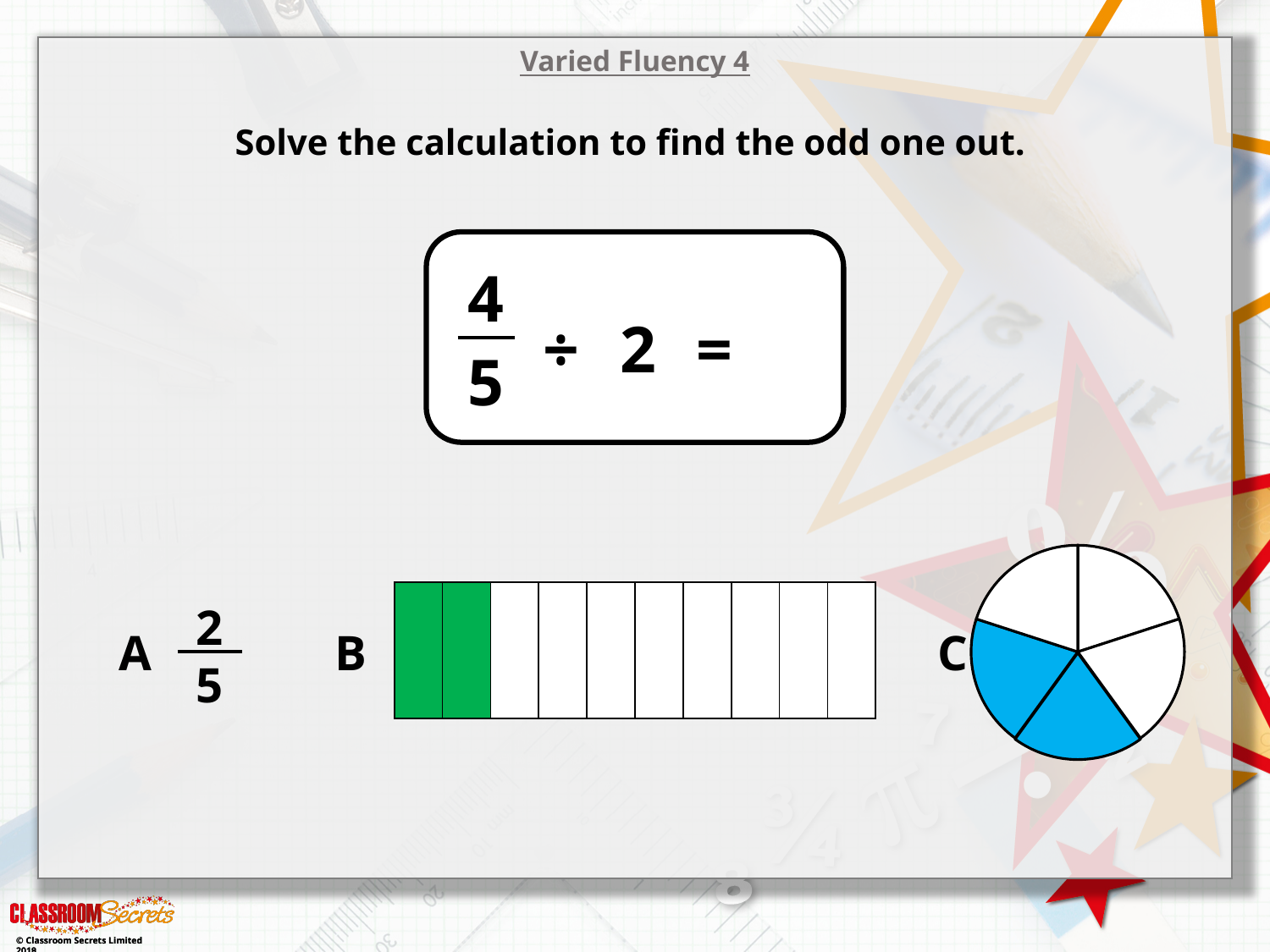
How many sections of the bar in diagram B are shaded green? 2 What colour are the shaded sections of the bar in diagram B? green How many slices is the pie in diagram C divided into? 5 How many slices of the pie in diagram C are shaded blue? 2 What fraction of the pie in diagram C is shaded blue? 2/5 In diagram C, are more slices shaded blue or left white? white What fraction of the bar in diagram B is shaded green? 2/10 What kind of chart is diagram C on the slide? pie chart What colour are the shaded slices of the pie in diagram C? blue